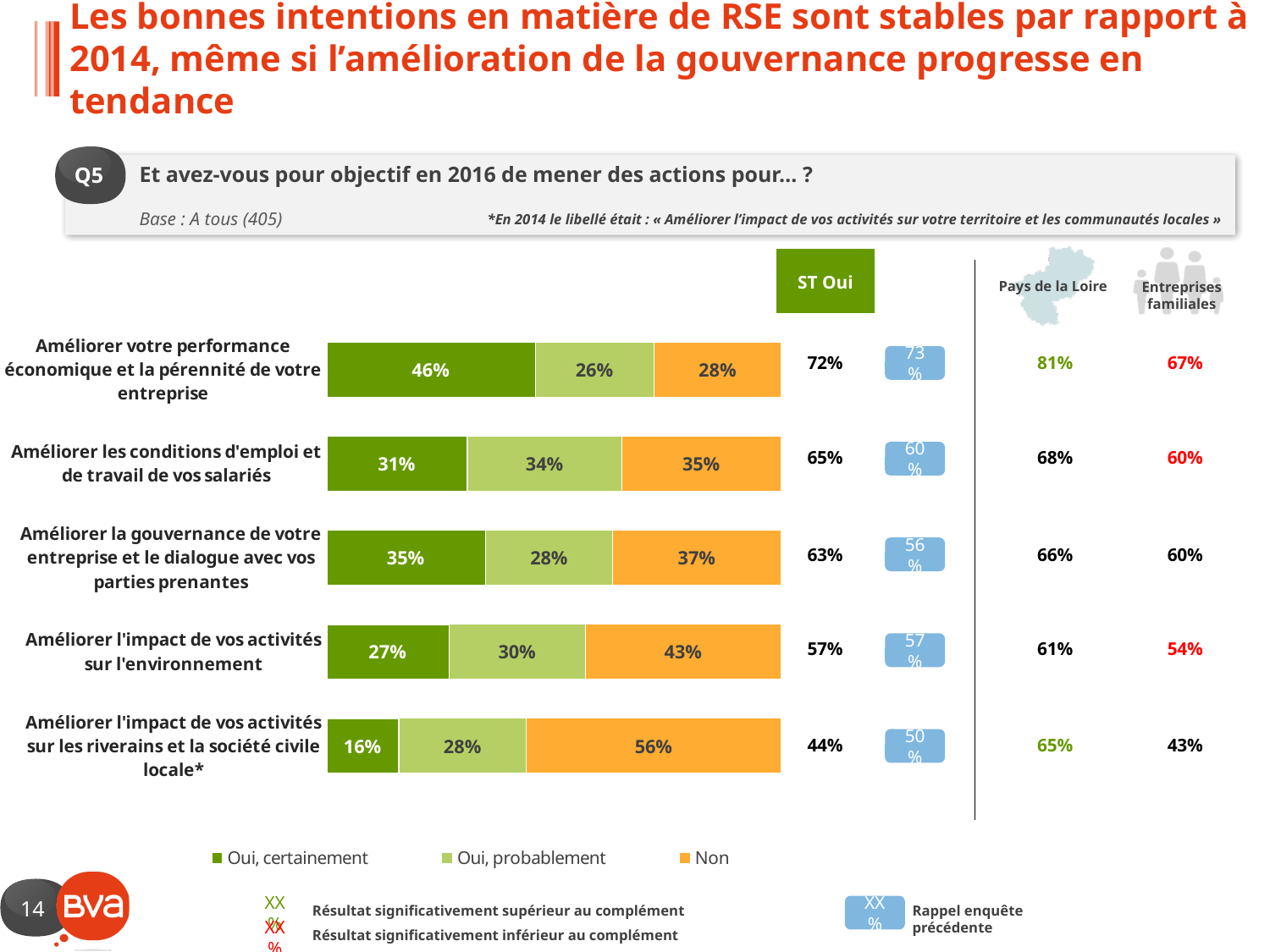
Which category has the lowest 'Oui, certainement' value? Améliorer l'impact de vos activités sur les riverains et la société civile locale* What colour represents the 'Non' series in the chart? Orange Which category has the highest 'Oui, certainement' value? Améliorer votre performance économique et la pérennité de votre entreprise What is the 'ST Oui' value for 'Améliorer l'impact de vos activités sur l'environnement'? 57% Which is larger: the 'Oui, certainement' value for 'Améliorer la gouvernance de votre entreprise et le dialogue avec vos parties prenantes' or for 'Améliorer les conditions d'emploi et de travail de vos salariés'? Améliorer la gouvernance de votre entreprise et le dialogue avec vos parties prenantes What is the 'Oui, certainement' value for 'Améliorer votre performance économique et la pérennité de votre entreprise'? 46% What kind of chart is shown on the slide? Stacked bar chart What is the 'Oui, probablement' value for 'Améliorer les conditions d'emploi et de travail de vos salariés'? 34% What is the difference between the 'Non' values for 'Améliorer l'impact de vos activités sur l'environnement' and 'Améliorer la gouvernance de votre entreprise et le dialogue avec vos parties prenantes'? 6% How many series does the legend list? 3 What is the 'Non' value for 'Améliorer l'impact de vos activités sur les riverains et la société civile locale*'? 56% How many categories (actions) are plotted in the chart? 5